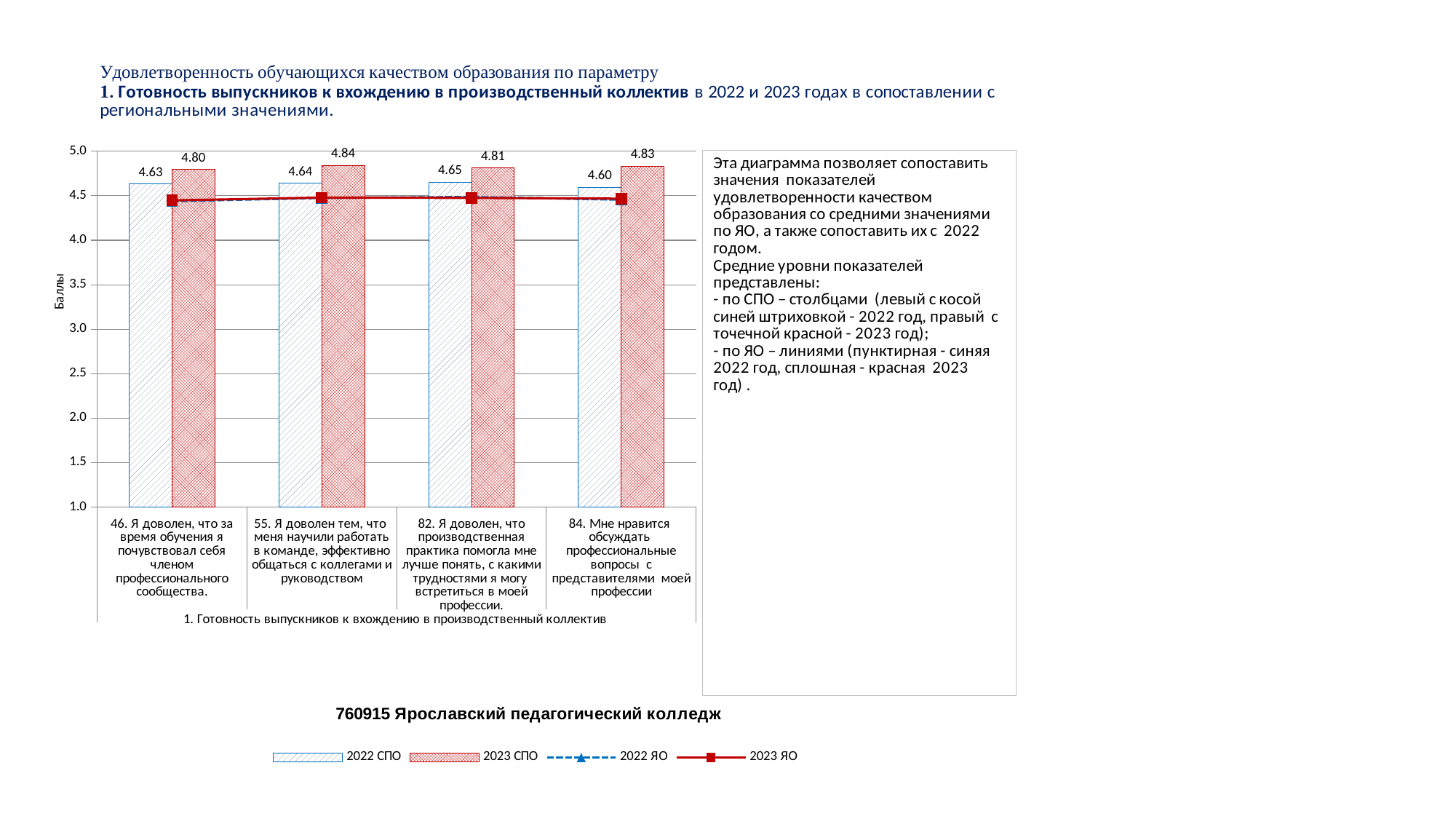
What is the 2022 СПО value for category 82 (Я доволен, что производственная практика помогла мне лучше понять...)? 4.65 Which category has the lowest 2022 СПО value? 84. Мне нравится обсуждать профессиональные вопросы с представителями моей профессии How many series does the legend list? 4 What is the 2022 СПО value for category 46 (Я доволен, что за время обучения я почувствовал себя членом профессионального сообщества)? 4.63 What is the 2023 СПО value for category 55 (Я доволен тем, что меня научили работать в команде)? 4.84 What is the label of the vertical axis? Баллы Which category has the highest 2023 СПО value? 55. Я доволен тем, что меня научили работать в команде, эффективно общаться с коллегами и руководством How many categories are shown on the x axis? 4 What is the 2023 СПО value for category 84 (Мне нравится обсуждать профессиональные вопросы с представителями моей профессии)? 4.83 What is the difference between the 2023 СПО and 2022 СПО values for category 84? 0.23 Is the 2023 ЯО line value for category 46 greater or less than 4.0? greater Which is larger for category 46: the 2022 СПО value or the 2023 СПО value? 2023 СПО